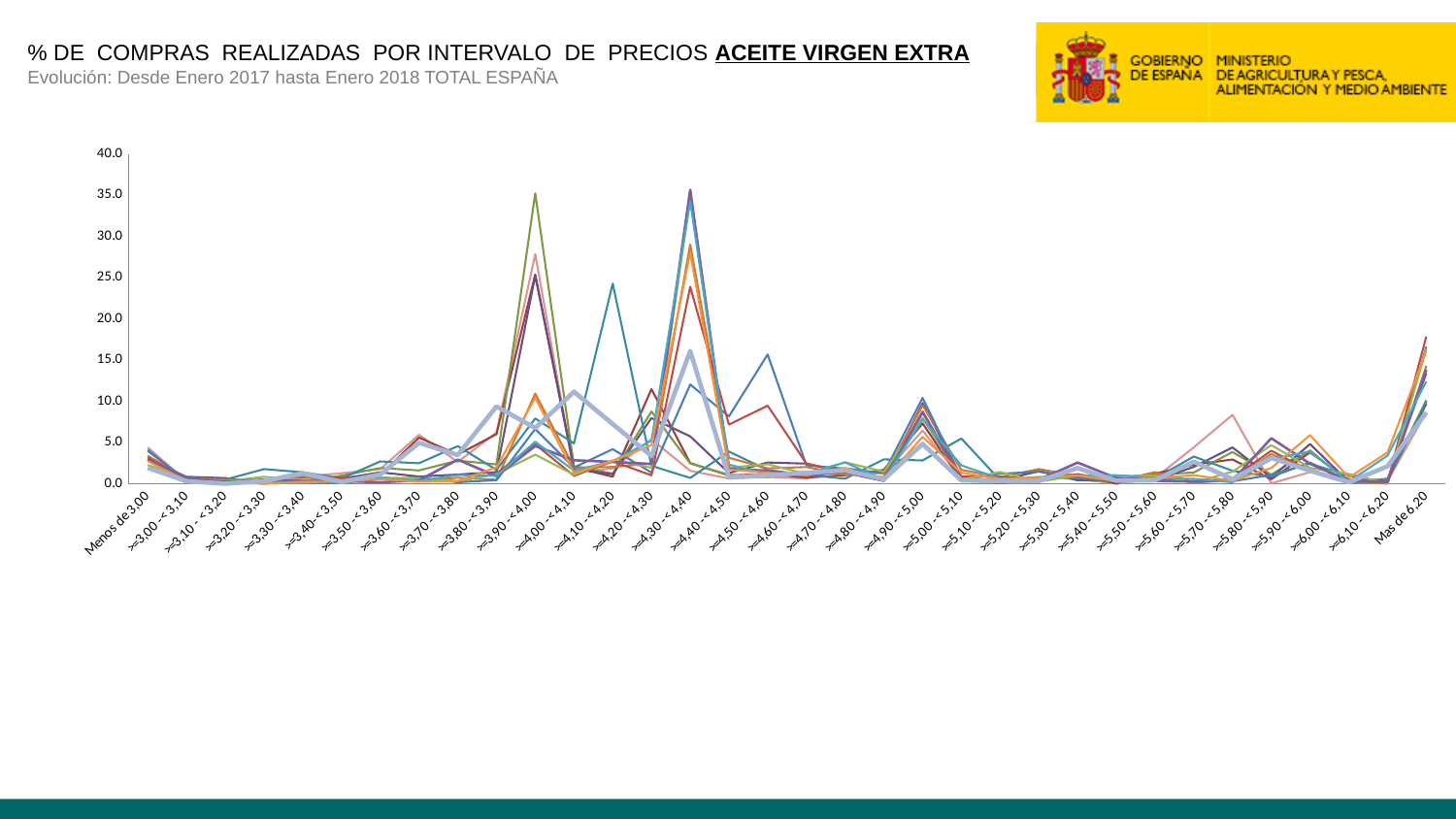
Is the highest value plotted at the interval >=3,10 - <3,20 greater or less than 5? less What kind of chart is shown on the slide? line chart Is the highest value plotted at the interval >=4,30 - <4,40 greater or less than 30? greater Is the highest value plotted at the interval >=3,90 - <4,00 greater or less than 30? greater How many price-interval categories are shown along the x axis? 34 What is the title of the chart on the slide? % DE COMPRAS REALIZADAS POR INTERVALO DE PRECIOS ACEITE VIRGEN EXTRA What is the highest tick value shown on the y axis? 40.0